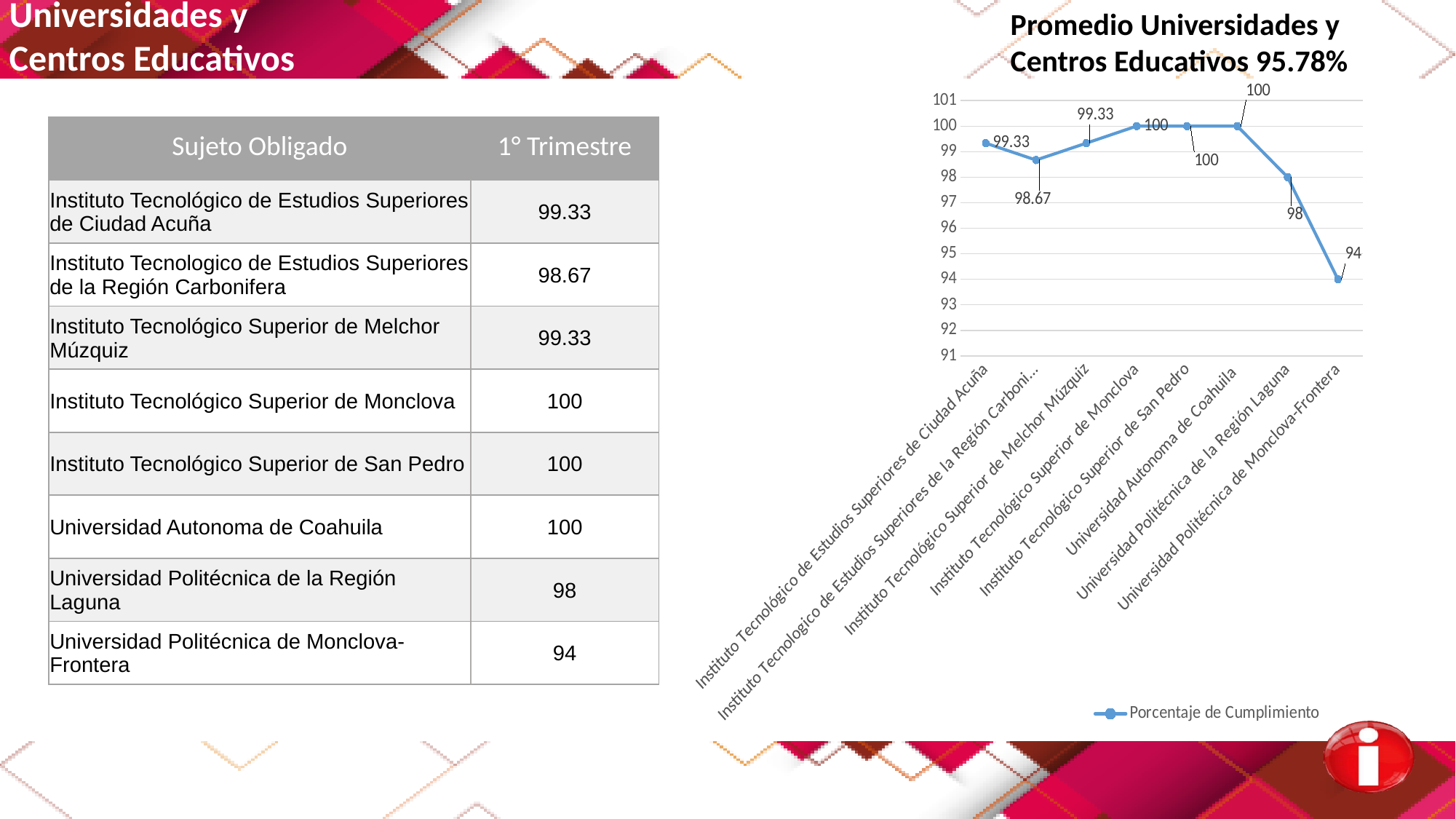
What kind of chart is shown on the slide? line chart What is the value for Instituto Tecnológico Superior de Melchor Múzquiz in the chart? 99.33 What is the value for Universidad Politécnica de Monclova-Frontera in the chart? 94 Which is larger: the value for Instituto Tecnológico de Estudios Superiores de Ciudad Acuña or the value for Universidad Politécnica de la Región Laguna? Instituto Tecnológico de Estudios Superiores de Ciudad Acuña How many categories are plotted in the chart? 8 Which category has the lowest value in the chart? Universidad Politécnica de Monclova-Frontera What is the name of the series shown in the chart legend? Porcentaje de Cumplimiento What is the value for Universidad Autonoma de Coahuila in the chart? 100 How many series does the chart legend list? 1 What is the difference between the values for Instituto Tecnológico Superior de Monclova and Instituto Tecnológico Superior de Melchor Múzquiz? 0.67 What is the value for Universidad Politécnica de la Región Laguna in the chart? 98 What is the difference between the values for Universidad Politécnica de la Región Laguna and Universidad Politécnica de Monclova-Frontera? 4